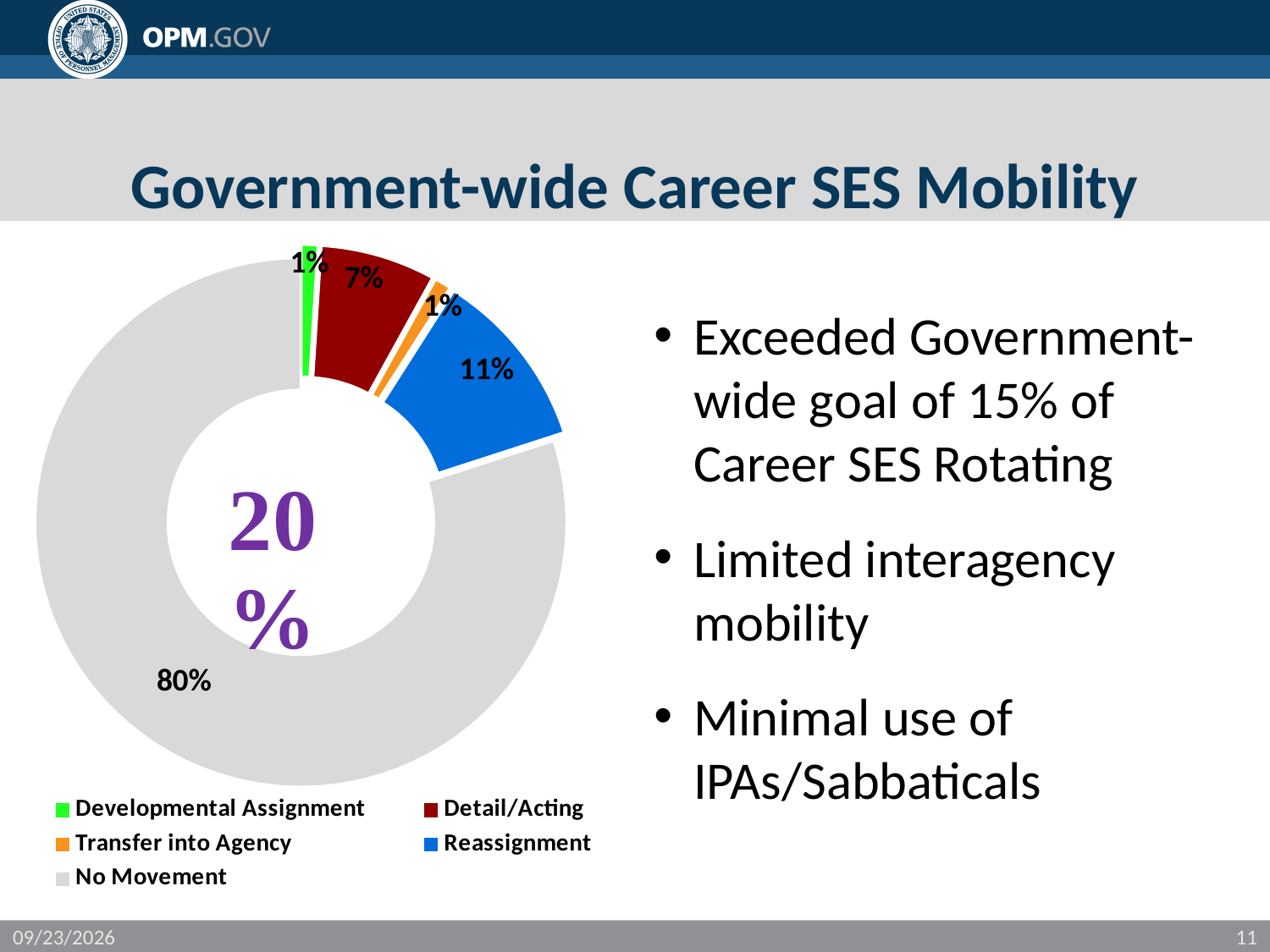
Which category has the largest slice of the chart? No Movement What colour represents Reassignment in the chart? Blue What share of the doughnut chart is labelled No Movement? 80% What kind of chart is shown on the slide? Doughnut chart What percentage is shown for Reassignment? 11% How many categories does the chart's legend list? 5 What percentage is shown for Detail/Acting? 7% What is the difference in percentage points between No Movement and Reassignment? 69% Which is larger, Reassignment or Detail/Acting? Reassignment What is the difference in percentage points between Reassignment and Detail/Acting? 4% What number is printed in the centre of the doughnut chart? 20% What percentage is shown for Developmental Assignment? 1%